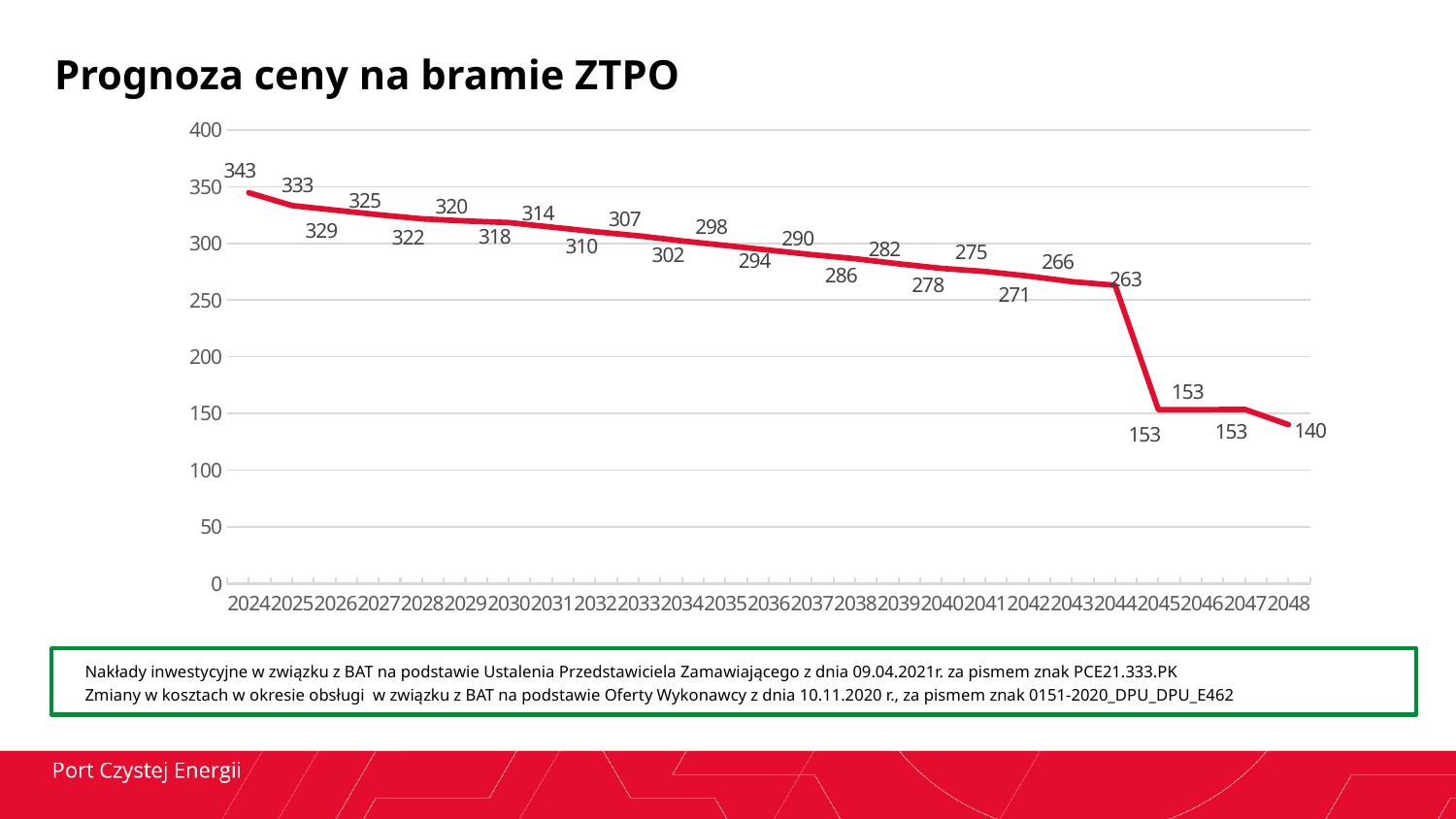
What is the difference between the values for 2044 and 2045? 110 What is the value for 2035? 298 Is the value for 2046 greater or less than 200? less Do the values rise or fall from 2024 to 2048? fall What kind of chart is shown? line chart Which year has the lowest value? 2048 How many years are plotted on the x axis? 25 What is the value for 2024? 343 What is the value for 2044? 263 Which year has the highest value? 2024 What is the value for 2048? 140 Which is larger, the value for 2030 or the value for 2040? 2030